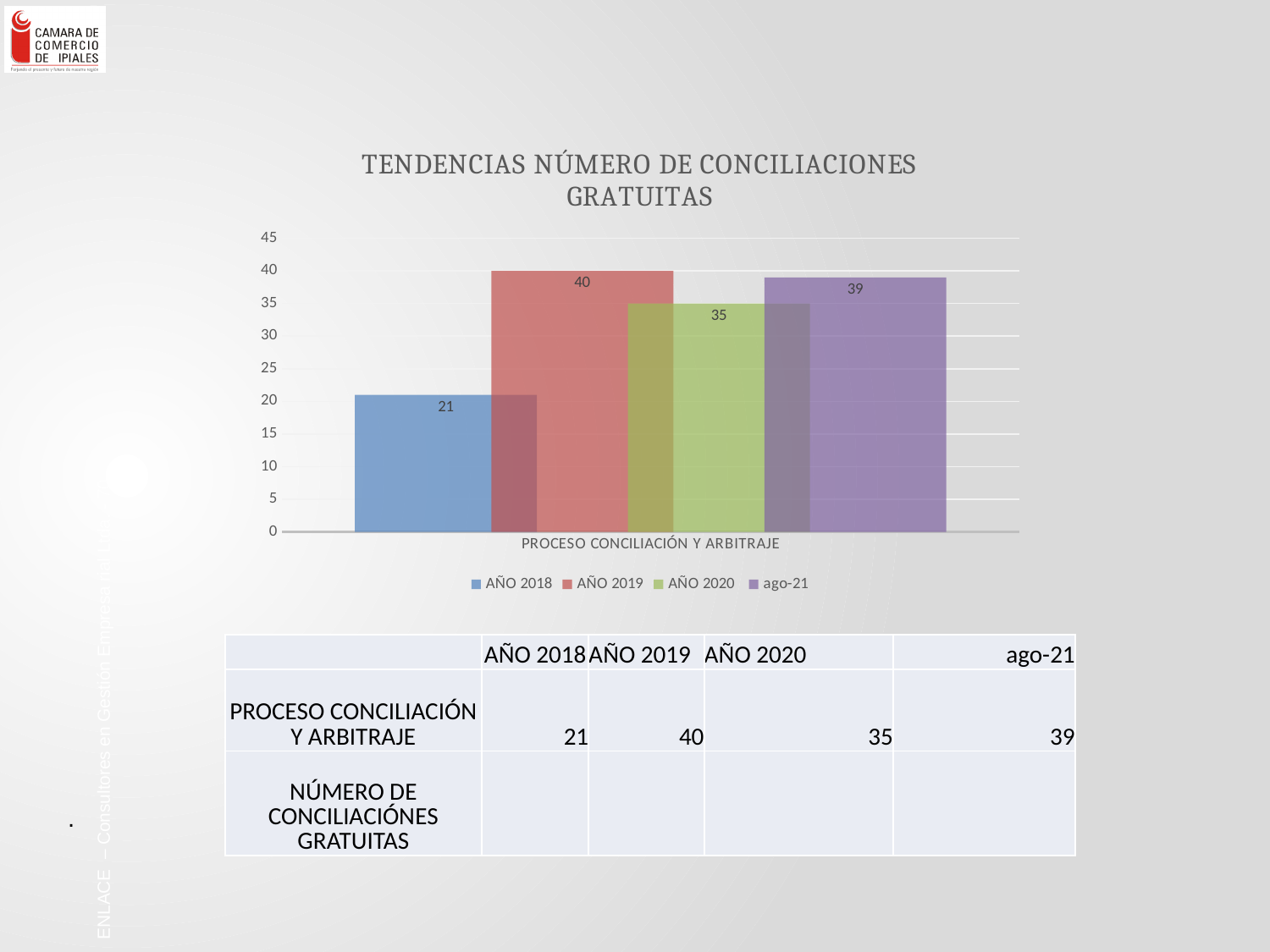
What is the category label shown on the x axis of the chart? PROCESO CONCILIACIÓN Y ARBITRAJE Which series has the lowest value in the chart? AÑO 2018 What is the difference between the values for AÑO 2019 and AÑO 2018? 19 What is the value for AÑO 2019 in the chart? 40 Which series has the highest value in the chart? AÑO 2019 What is the title of the chart? TENDENCIAS NÚMERO DE CONCILIACIONES GRATUITAS How many series does the legend list? 4 What is the value for ago-21 in the chart? 39 What is the value for AÑO 2018 in the chart? 21 What kind of chart is shown on the slide? Bar chart Which is larger, the value for AÑO 2020 or the value for ago-21? ago-21 What is the value for AÑO 2020 in the chart? 35